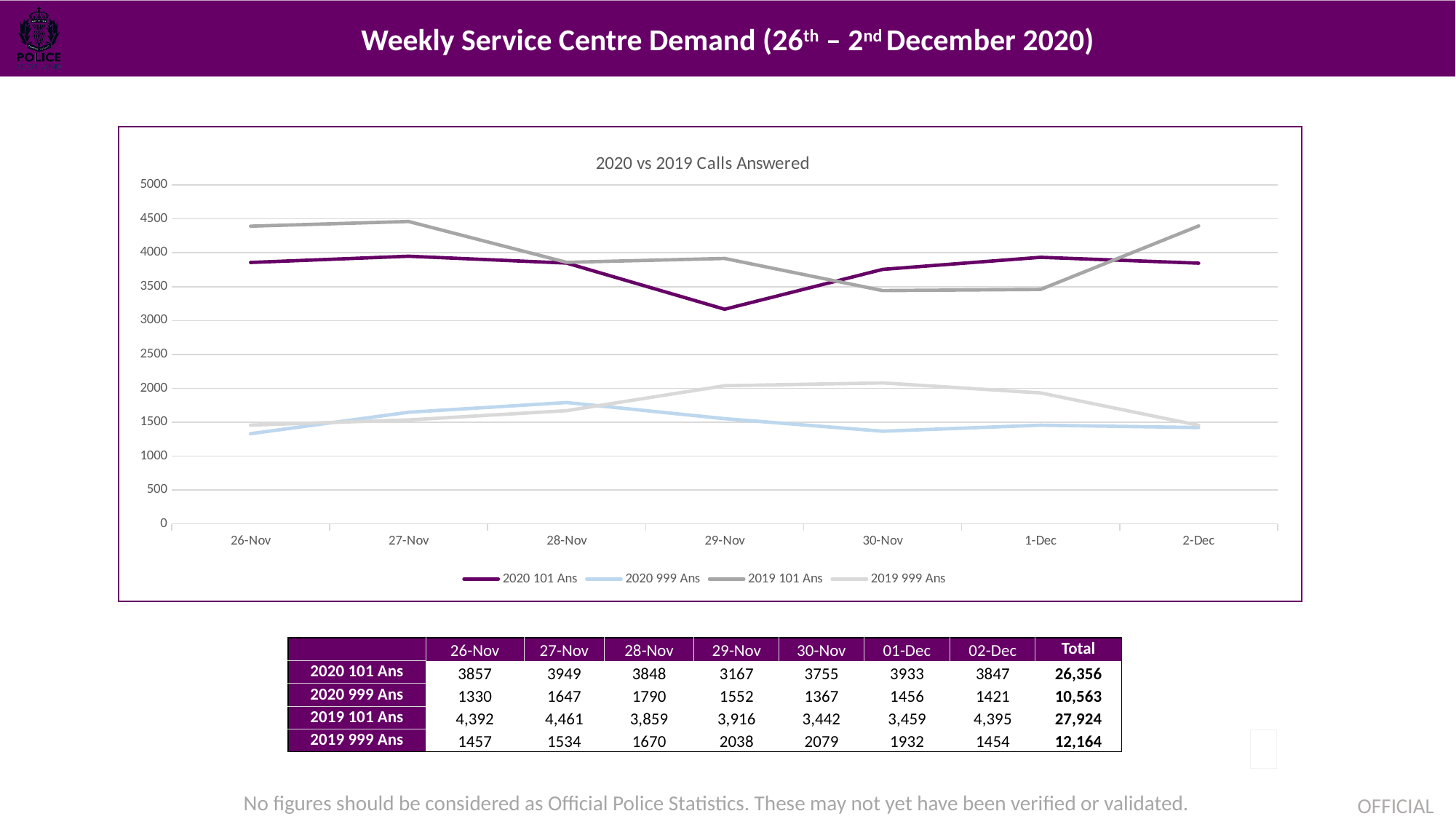
What kind of chart is shown on the slide? line chart On 28-Nov, which is larger: 2020 999 Ans or 2019 999 Ans? 2020 999 Ans Does the 2019 999 Ans series rise or fall from 26-Nov to 30-Nov? rise How many dates are plotted along the x axis of the chart? 7 What is the value for 2019 999 Ans on 30-Nov? 2079 What is the title of the chart? 2020 vs 2019 Calls Answered How many series does the legend of the chart list? 4 Is the value for 2019 101 Ans on 27-Nov greater or less than 4000? greater What is the difference between 2019 101 Ans and 2020 101 Ans on 26-Nov? 535 On which date is the 2020 101 Ans series at its lowest? 29-Nov What is the value for 2020 101 Ans on 29-Nov? 3167 On which date is the 2019 101 Ans series at its highest? 27-Nov